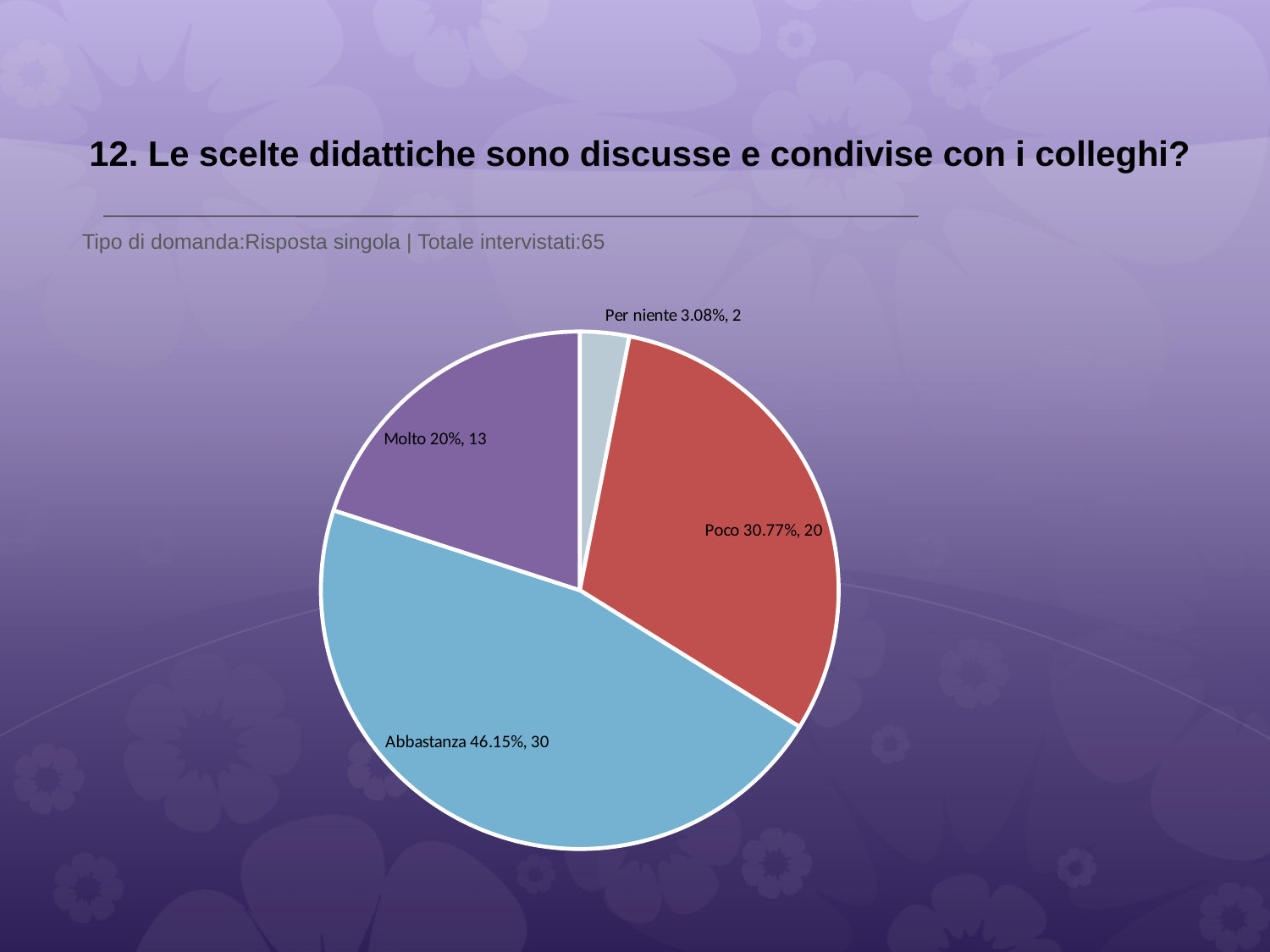
What colour is the 'Abbastanza' slice? light blue How many respondents answered 'Molto'? 13 How many slices does the pie chart have? 4 What kind of chart is shown on the slide? pie chart What percentage share does the 'Abbastanza' slice have? 46.15% What is the total number of respondents shown on the slide? 65 Which has more respondents, 'Molto' or 'Poco'? Poco What is the difference in respondent count between 'Abbastanza' and 'Poco'? 10 How many respondents answered 'Poco'? 20 Which category has the smallest slice? Per niente What percentage share does the 'Per niente' slice have? 3.08% Which category has the largest slice? Abbastanza